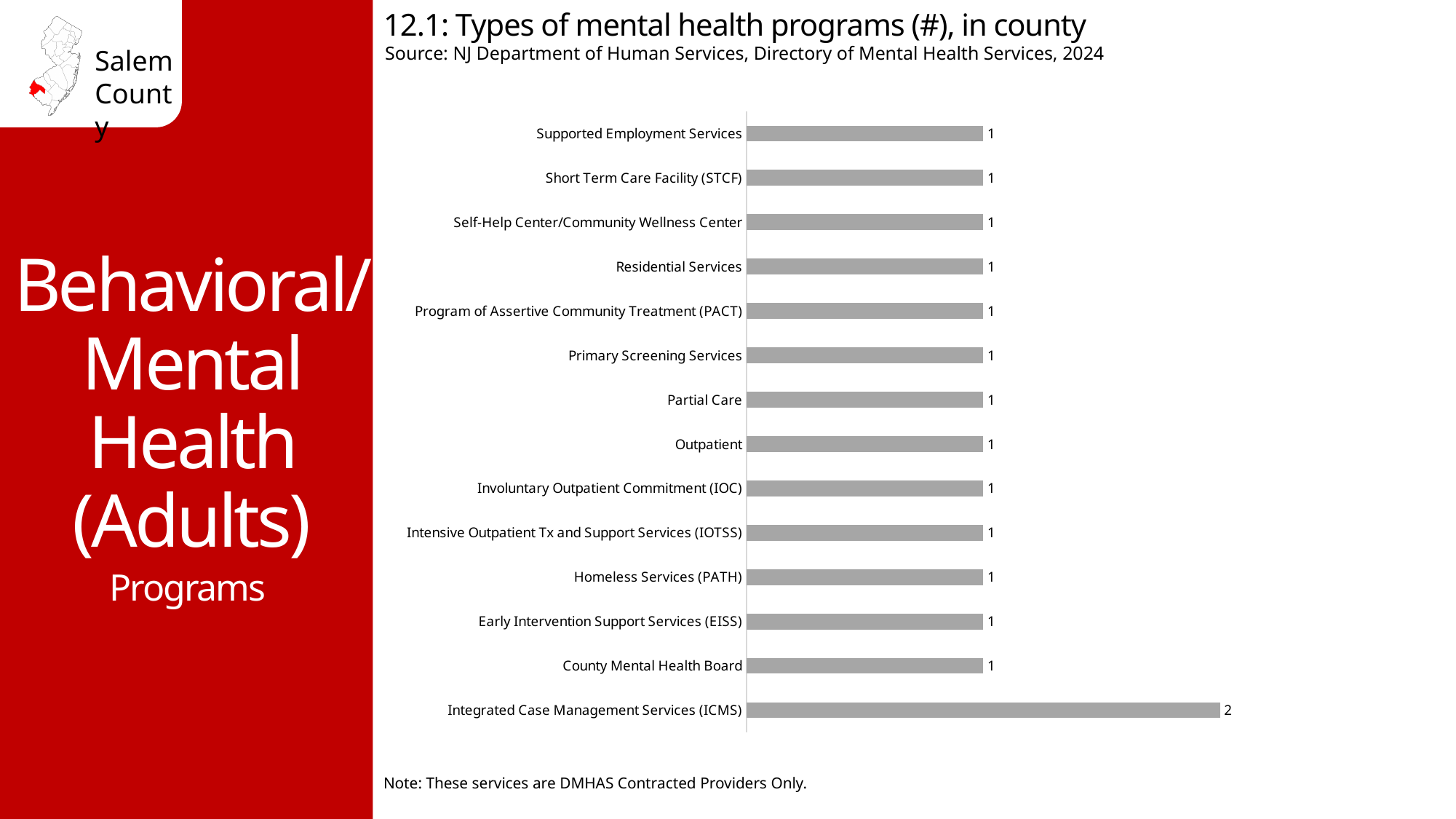
Which category has the highest value? Integrated Case Management Services (ICMS) What is the value for Integrated Case Management Services (ICMS)? 2 What is the title of the chart? 12.1: Types of mental health programs (#), in county What is the source cited for the chart? NJ Department of Human Services, Directory of Mental Health Services, 2024 What is the value for Program of Assertive Community Treatment (PACT)? 1 What is the value for Homeless Services (PATH)? 1 What kind of chart is shown on the slide? Bar chart What is the value for Partial Care? 1 Which is larger, the value for Integrated Case Management Services (ICMS) or the value for Outpatient? Integrated Case Management Services (ICMS) How many categories are shown in the chart? 14 What is the difference between the values for Integrated Case Management Services (ICMS) and County Mental Health Board? 1 What is the value for Short Term Care Facility (STCF)? 1